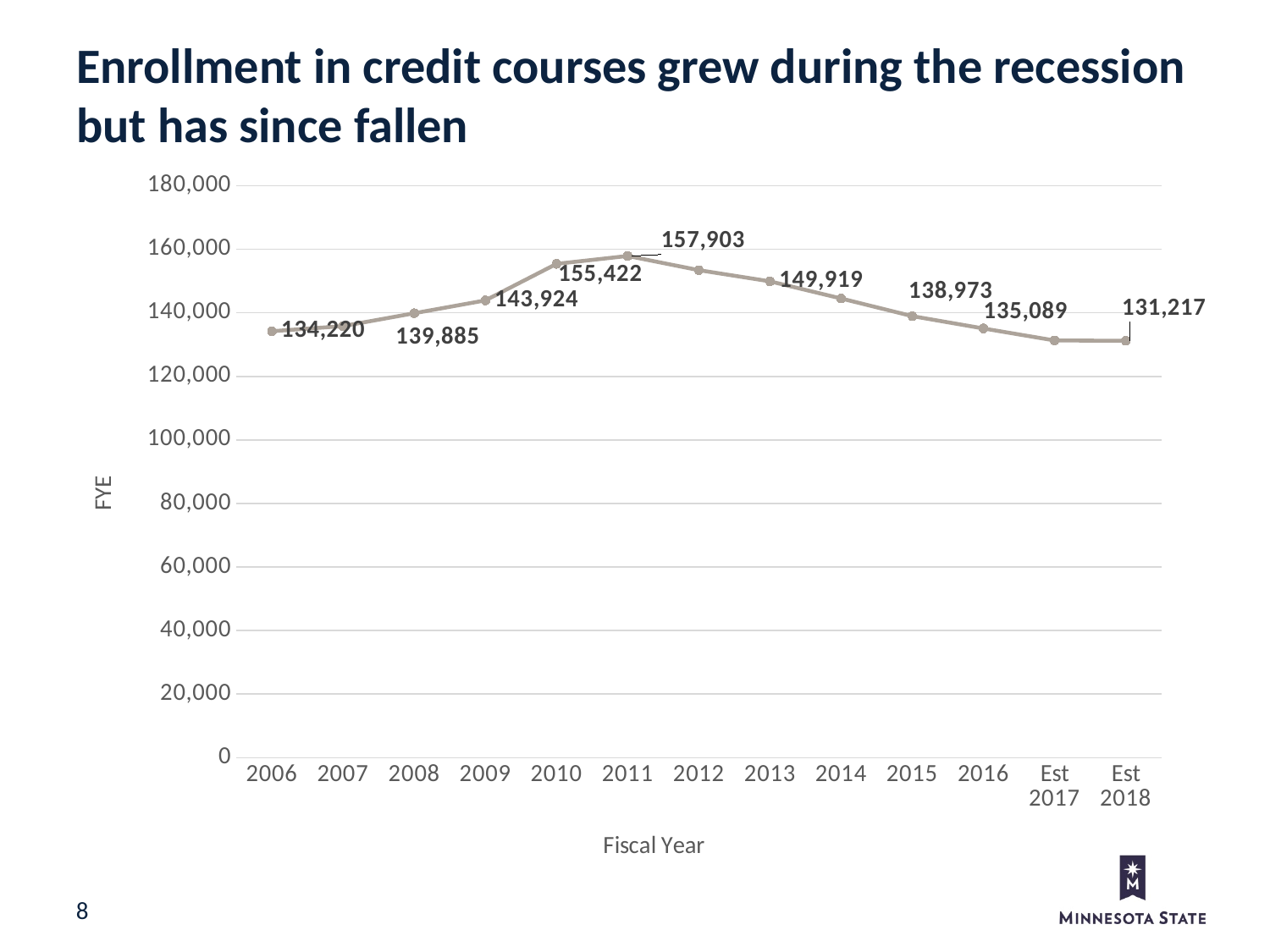
What was the FYE enrollment in fiscal year 2010? 155,422 Does FYE enrollment rise or fall from fiscal year 2011 to Est 2018? Fall How many fiscal years are plotted on the x axis? 13 By how much did FYE increase from fiscal year 2010 to fiscal year 2011? 2,481 Which fiscal year had the highest FYE enrollment? 2011 What type of chart is shown on the slide? Line chart Is the value for fiscal year 2012 greater or less than 140,000? greater What was the FYE enrollment in fiscal year 2015? 138,973 What is the estimated FYE enrollment for fiscal year 2018? 131,217 What was the FYE enrollment in fiscal year 2006? 134,220 What is the difference in FYE between fiscal year 2011 and fiscal year 2006? 23,683 Which fiscal year had a higher FYE, 2010 or 2013? 2010